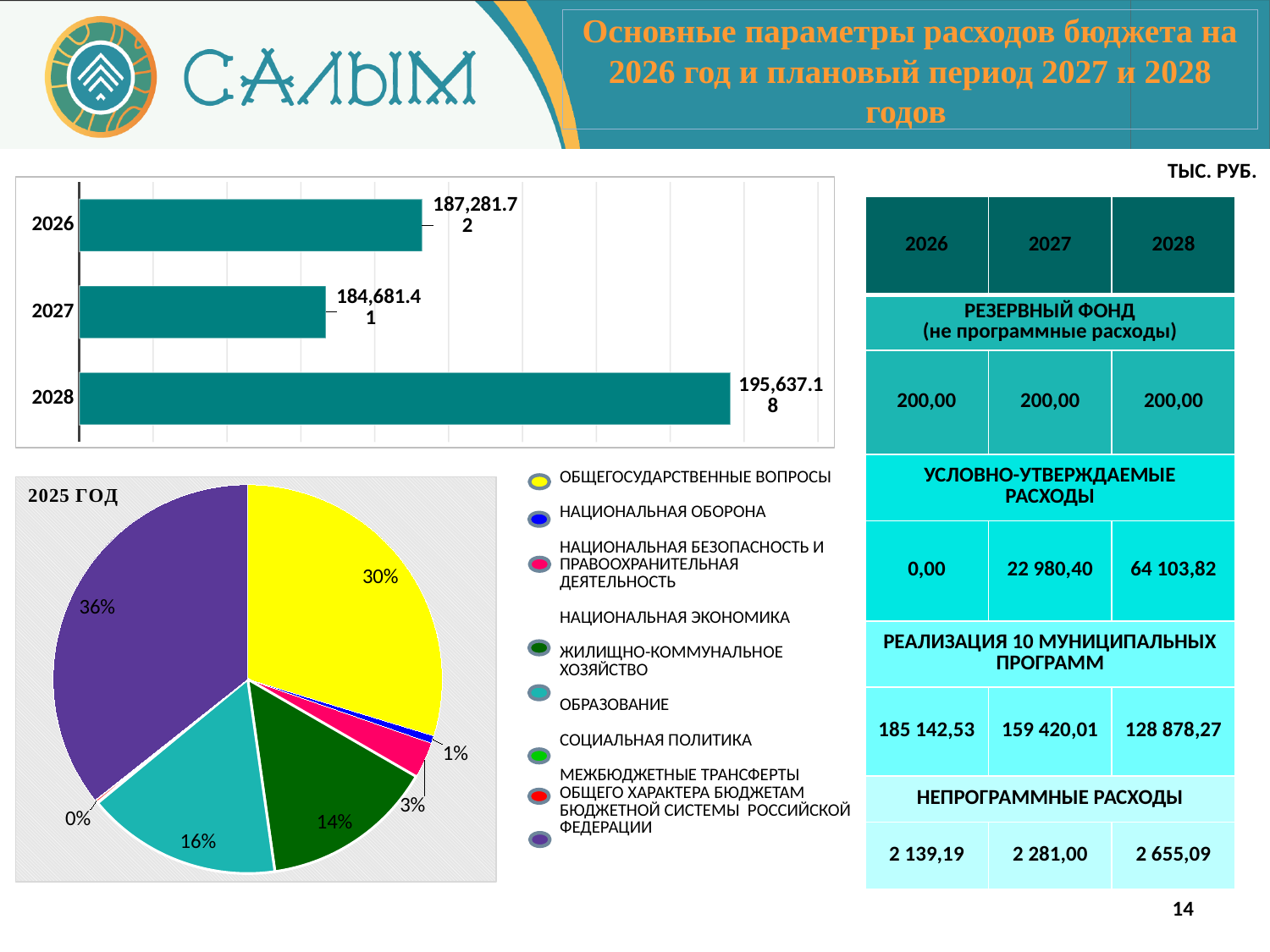
In the bar chart, what is the value for 2026? 187,281.72 In the bar chart, which year has the lowest value? 2027 In the bar chart, which year has the highest value? 2028 In the bar chart, which is larger, the value for 2026 or the value for 2028? 2028 What kind of chart is the chart in the top left of the slide? bar chart In the pie chart titled 2025 ГОД, what share does the largest slice (purple) have? 36% In the bar chart, what is the value for 2028? 195,637.18 In the bar chart, what is the value for 2027? 184,681.41 In the pie chart titled 2025 ГОД, what share does the yellow slice have? 30% In the bar chart, what is the difference between the values for 2026 and 2027? 2,600.31 How many bars are shown in the bar chart? 3 In the bar chart, what is the difference between the values for 2028 and 2027? 10,955.77